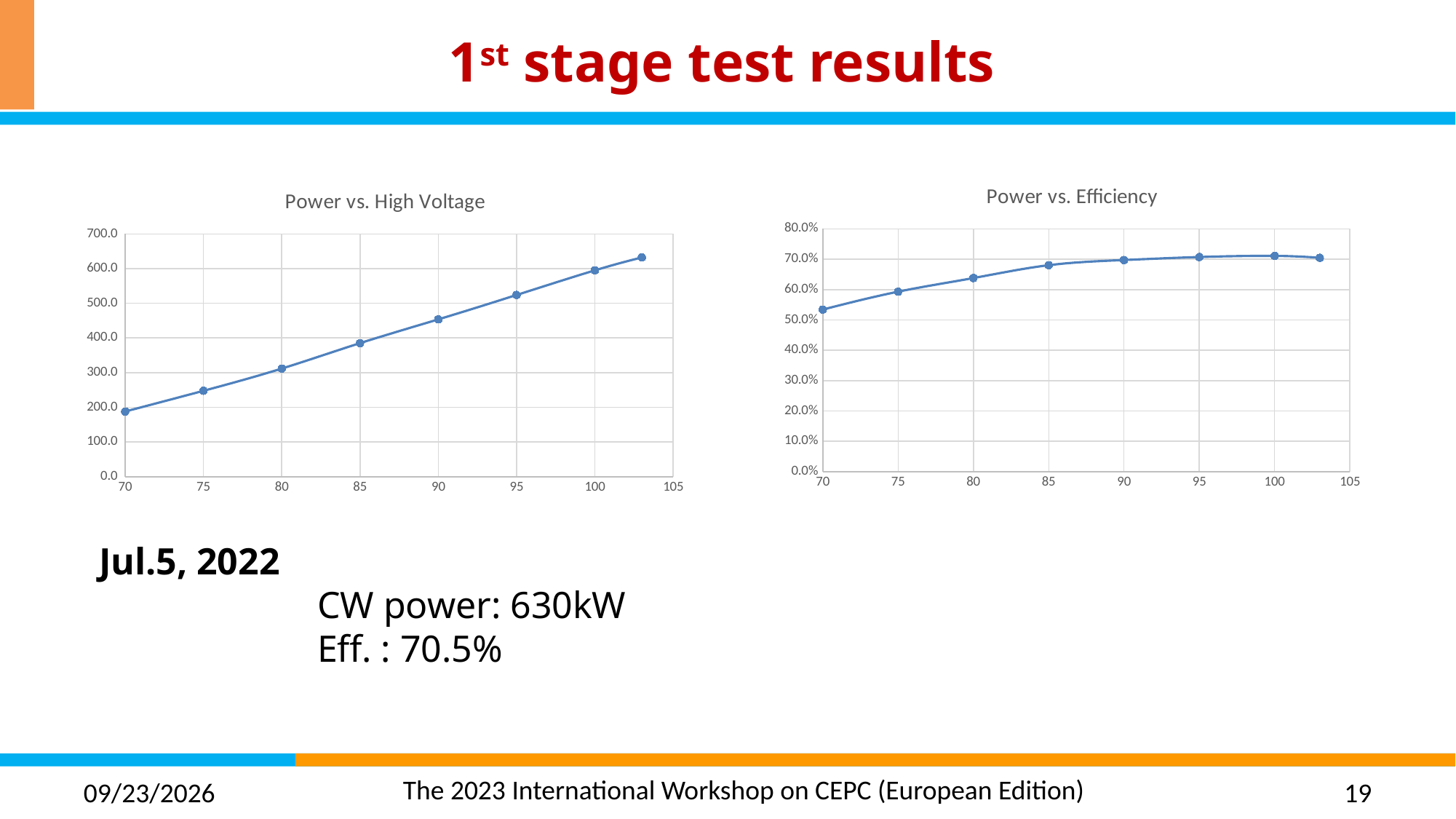
In the "Power vs. High Voltage" chart, is the value at x = 100 greater or less than 500.0? greater What type of chart is the "Power vs. High Voltage" chart? line chart How many data points are plotted on the "Power vs. High Voltage" chart? 8 How many data points are plotted on the "Power vs. Efficiency" chart? 8 In the "Power vs. High Voltage" chart, is the value at x = 90 greater or less than 400.0? greater What is the title of the chart on the right side of the slide? Power vs. Efficiency In the "Power vs. Efficiency" chart, is the value at x = 70 greater or less than 50.0%? greater In the "Power vs. High Voltage" chart, which is larger: the value at x = 80 or the value at x = 95? x = 95 In the "Power vs. High Voltage" chart, do the values rise or fall as the x axis increases? rise In the "Power vs. High Voltage" chart, at which x value is the plotted value lowest? 70